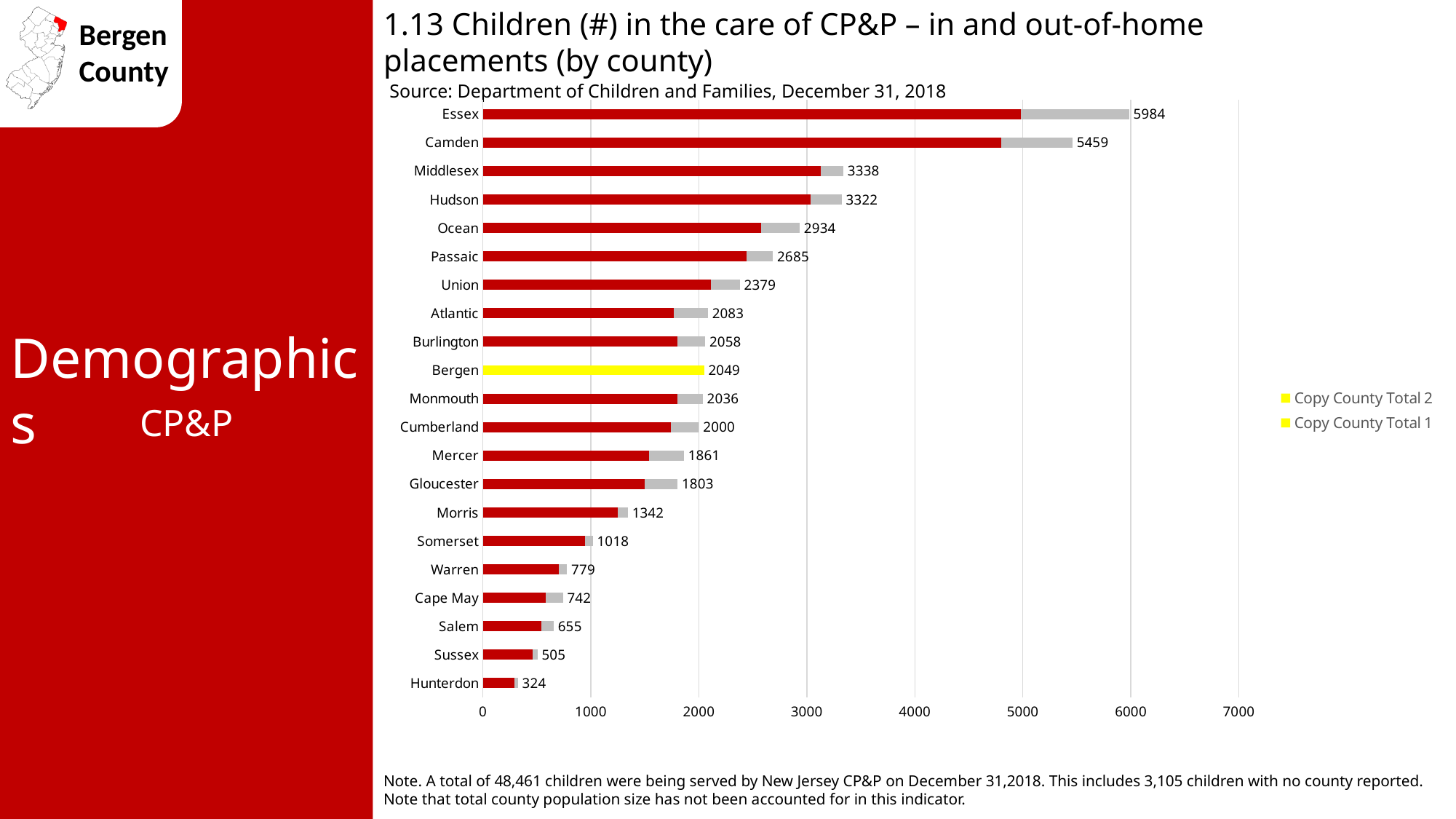
What is the difference between the values for Burlington and Bergen? 9 What colour is the bar for Bergen county? Yellow Which county has a larger value, Ocean or Passaic? Ocean What is the difference between the values for Essex and Camden? 525 What is the total number of children in the care of CP&P for Essex county? 5984 Is the red segment of the Essex bar greater or less than 4000? greater Which county has the lowest number of children in the care of CP&P? Hunterdon What is the value shown for Hunterdon county? 324 Which county has the highest number of children in the care of CP&P? Essex What is the value shown for Bergen county? 2049 How many counties are shown on the chart? 21 What is the value shown for Morris county? 1342